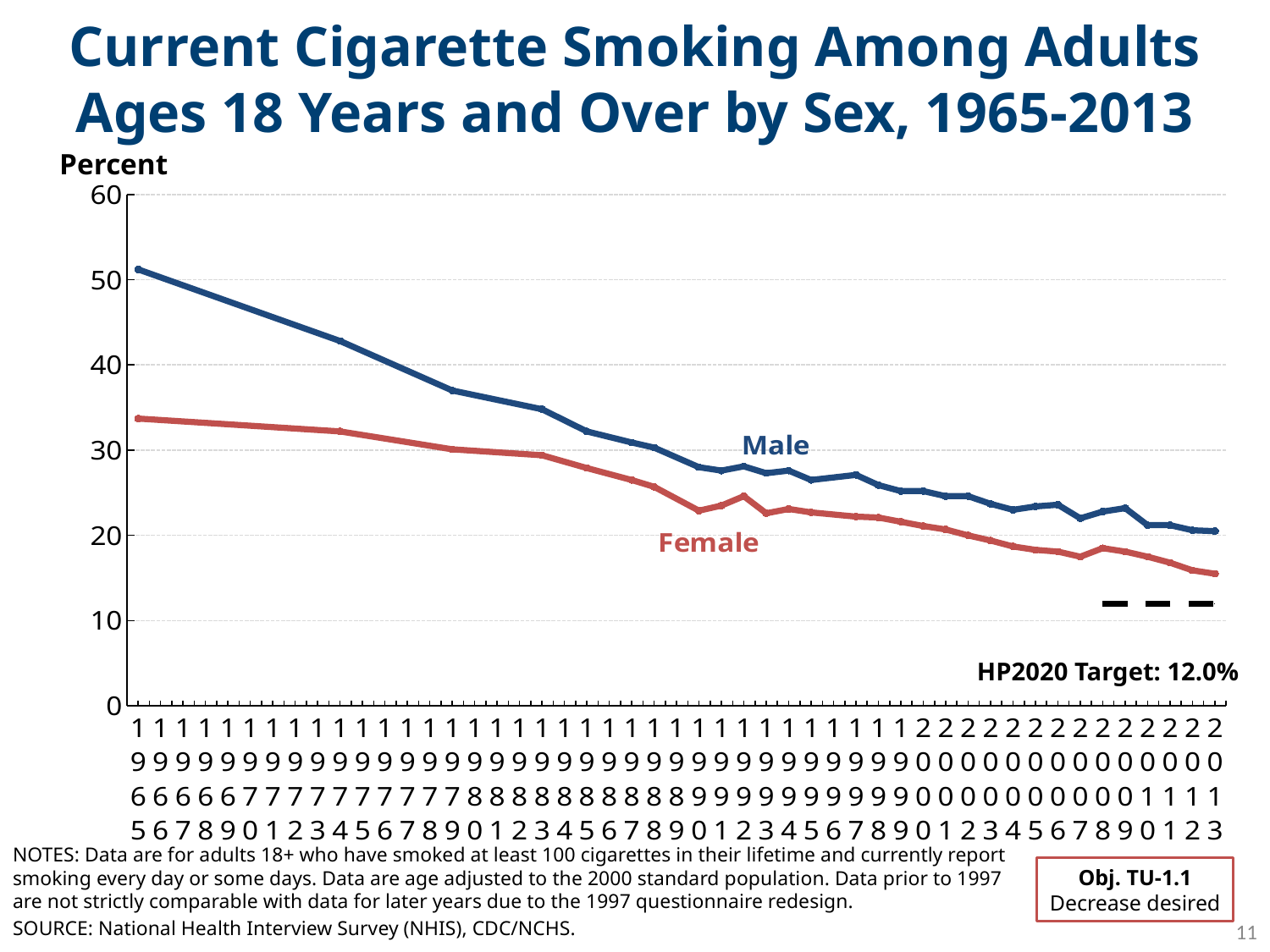
Is the Female value in 1965 greater or less than 30? greater Is the Female value in 2013 greater or less than 20? less Is the Male value in 1965 greater or less than 40? greater What kind of chart is shown on the slide? line chart What are the names of the two series plotted on the chart? Male and Female Does the Female smoking percentage rise or fall from 1965 to 2013? fall What is the label on the y axis of the chart? Percent In 2013, which series has the lower value, Male or Female? Female What is the HP2020 Target value shown on the chart? 12.0% In 1965, which series has the higher value, Male or Female? Male How many series are plotted on the chart? 3 Does the Male smoking percentage rise or fall from 1965 to 2013? fall